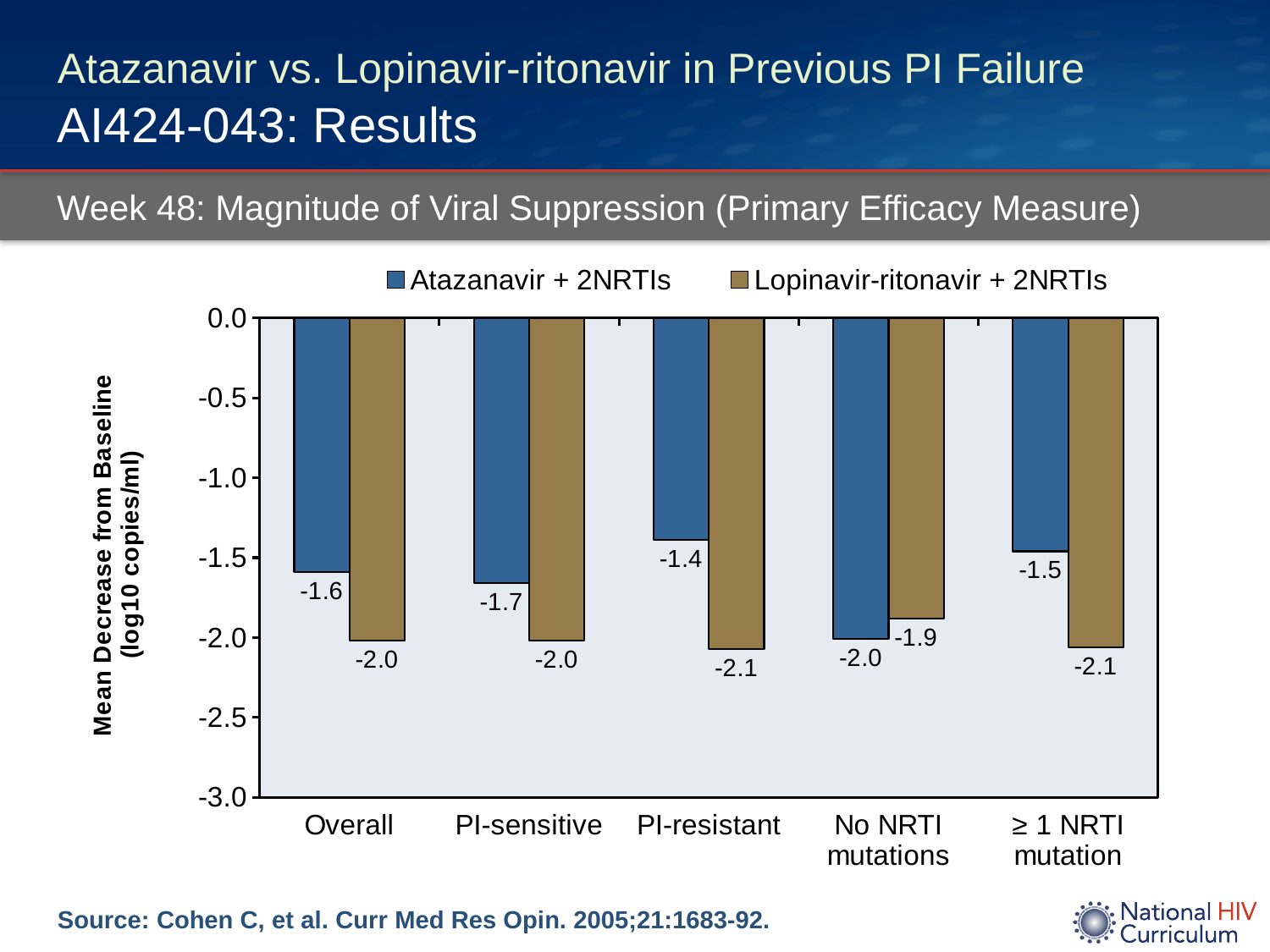
For Lopinavir-ritonavir + 2NRTIs, which category shows the smallest mean decrease from baseline (value closest to zero)? No NRTI mutations What is the value for Lopinavir-ritonavir + 2NRTIs in the ≥ 1 NRTI mutation category? -2.1 How many categories are shown on the x axis? 5 What is the value for Lopinavir-ritonavir + 2NRTIs in the PI-resistant category? -2.1 For Atazanavir + 2NRTIs, which category shows the largest mean decrease from baseline (most negative value)? No NRTI mutations What kind of chart is shown on the slide? Bar chart How many series does the legend list? 2 What is the value for Atazanavir + 2NRTIs in the Overall category? -1.6 In the Overall category, which series shows the larger mean decrease from baseline? Lopinavir-ritonavir + 2NRTIs For Atazanavir + 2NRTIs, which category shows the smallest mean decrease from baseline (value closest to zero)? PI-resistant In the PI-resistant category, what is the difference between the Lopinavir-ritonavir + 2NRTIs value and the Atazanavir + 2NRTIs value? 0.7 What is the value for Atazanavir + 2NRTIs in the No NRTI mutations category? -2.0